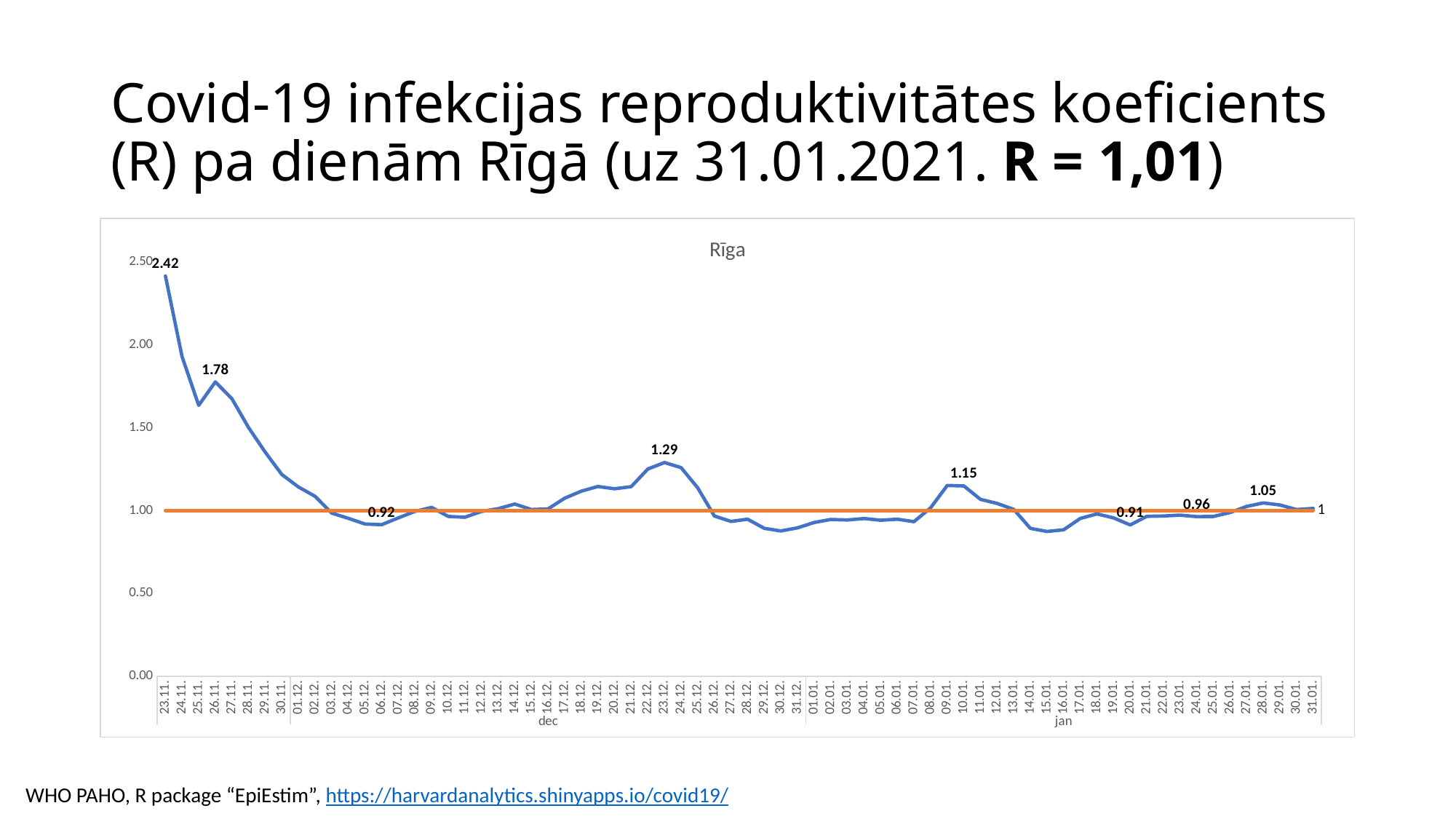
Which date has the larger R value, 23.12. or 09.01.? 23.12. Does the R value rise or fall from 23.11. to 06.12.? fall What is the R value on 23.11.? 2.42 Is the R value on 30.11. greater or less than 1.50? less What kind of chart is shown on the slide? line chart What is the difference between the R values on 23.11. and 26.11.? 0.64 What is the R value on 23.12.? 1.29 What is the title of the chart? Rīga What is the R value on 09.01.? 1.15 On which date is the R value highest? 23.11. What is the R value on 20.01.? 0.91 What is the R value on 26.11.? 1.78